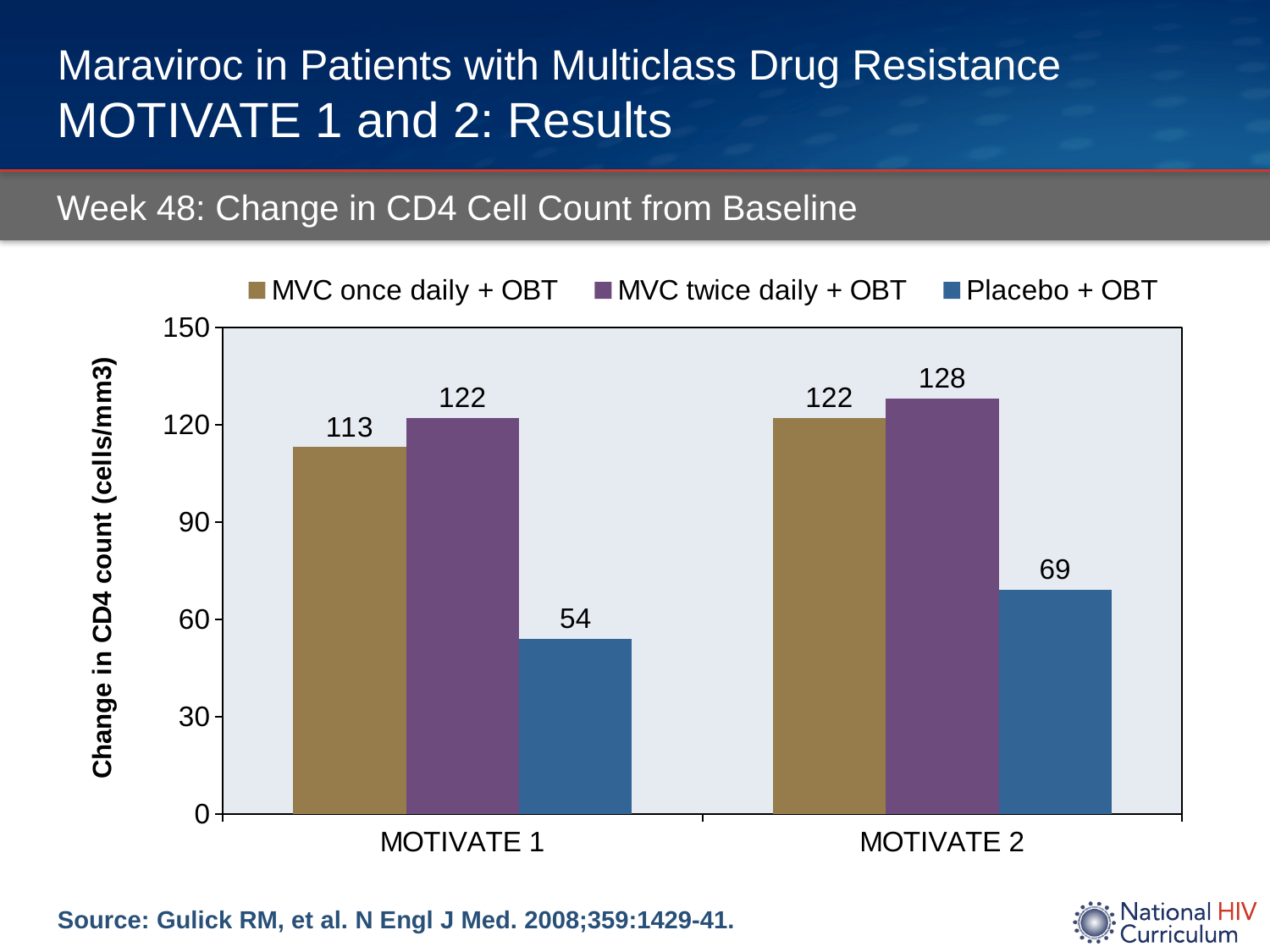
How many series does the legend list? 3 Which series has the highest value in MOTIVATE 2? MVC twice daily + OBT What is the change in CD4 count for MVC twice daily + OBT in MOTIVATE 2? 128 What is the change in CD4 count for Placebo + OBT in MOTIVATE 2? 69 How many study groups are shown on the x axis? 2 Which is larger: Placebo + OBT in MOTIVATE 1 or Placebo + OBT in MOTIVATE 2? Placebo + OBT in MOTIVATE 2 Is the value for MVC once daily + OBT in MOTIVATE 2 greater or less than 90? greater What is the difference between MVC twice daily + OBT in MOTIVATE 2 and MOTIVATE 1? 6 What is the difference between MVC twice daily + OBT and Placebo + OBT in MOTIVATE 1? 68 What kind of chart is shown on the slide? Bar chart Which series has the lowest value in MOTIVATE 1? Placebo + OBT What is the change in CD4 count for MVC once daily + OBT in MOTIVATE 1? 113